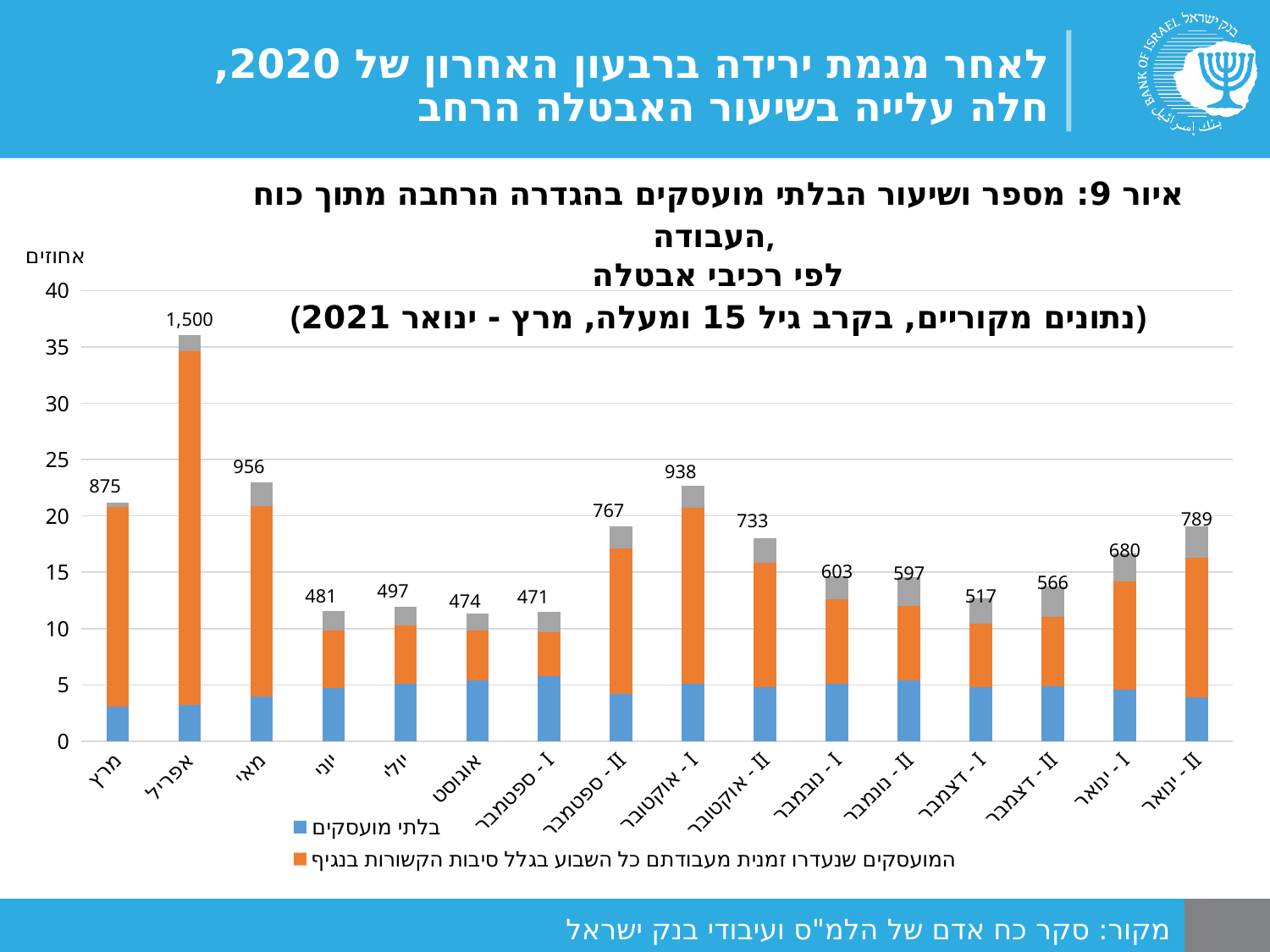
What is the data label shown above the bar for מרץ? 875 Which category has the highest data label? אפריל What unit label is written above the y axis? אחוזים Which category has the lowest data label? ספטמבר - I Is the total height of the bar for יוני greater or less than 15 on the y axis? less What is the difference between the data labels for אפריל and מרץ? 625 What is the data label shown above the bar for ינואר - II? 789 How many categories are shown on the x axis? 16 What is the data label shown above the bar for אפריל? 1,500 What is the data label shown above the bar for נובמבר - I? 603 What kind of chart is shown on the slide? stacked bar chart Which has the larger data label, מאי or אוקטובר - I? מאי